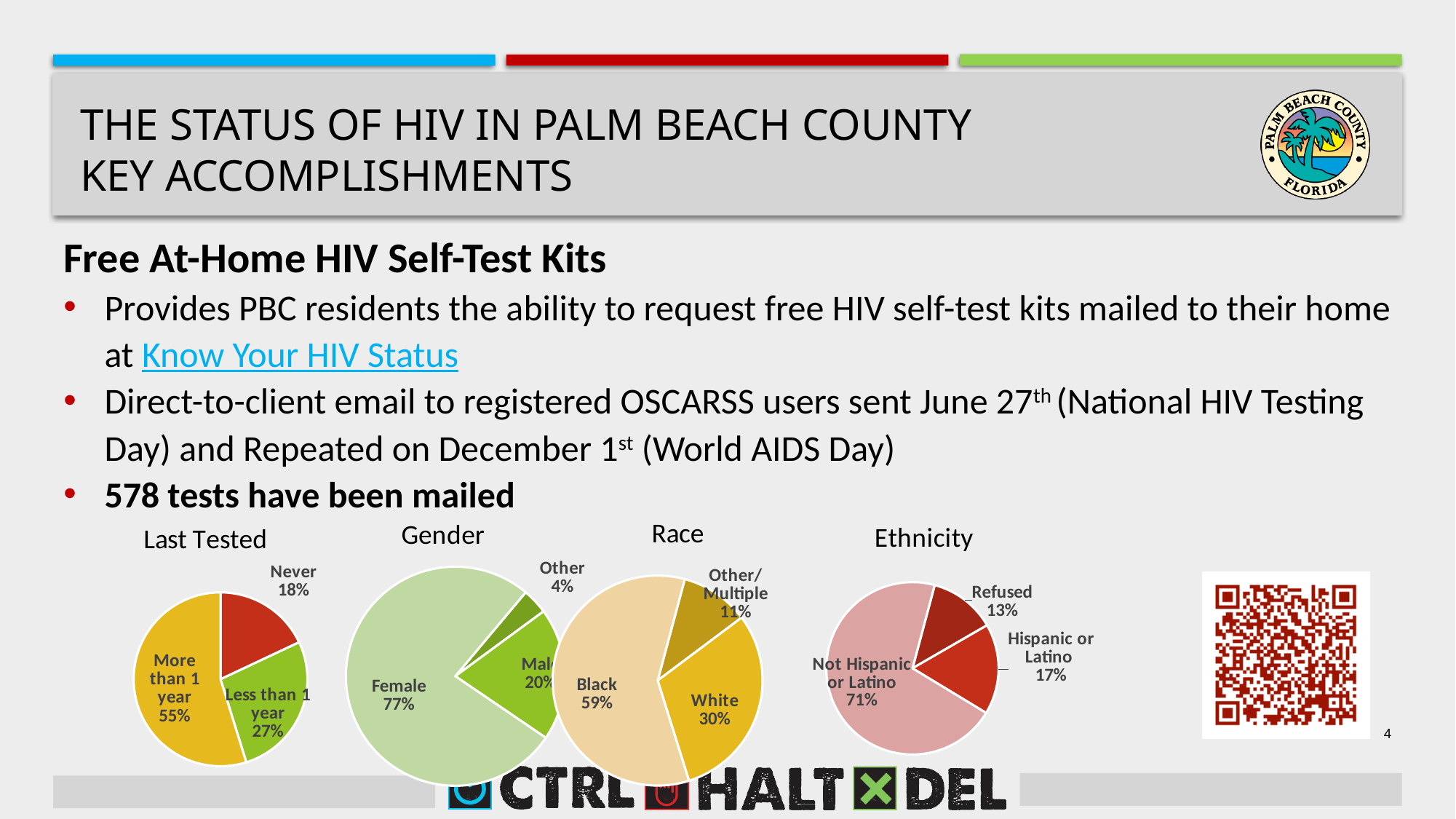
In the Ethnicity chart, which is larger, Refused or Hispanic or Latino? Hispanic or Latino In the Gender chart, what is the difference between the Female and Male shares? 57% In the Race chart, which category has the largest share? Black In the Gender chart, what percentage is Female? 77% How many pie charts are shown on the slide? 4 In the Race chart, what percentage is White? 30% In the Last Tested chart, what share of respondents were last tested more than 1 year ago? 55% In the Last Tested chart, what percentage of respondents have never been tested? 18% In the Gender chart, how many slices are there? 3 What kind of chart is the Race chart? Pie chart In the Last Tested chart, which category has the smallest share? Never In the Ethnicity chart, what percentage is Hispanic or Latino? 17%